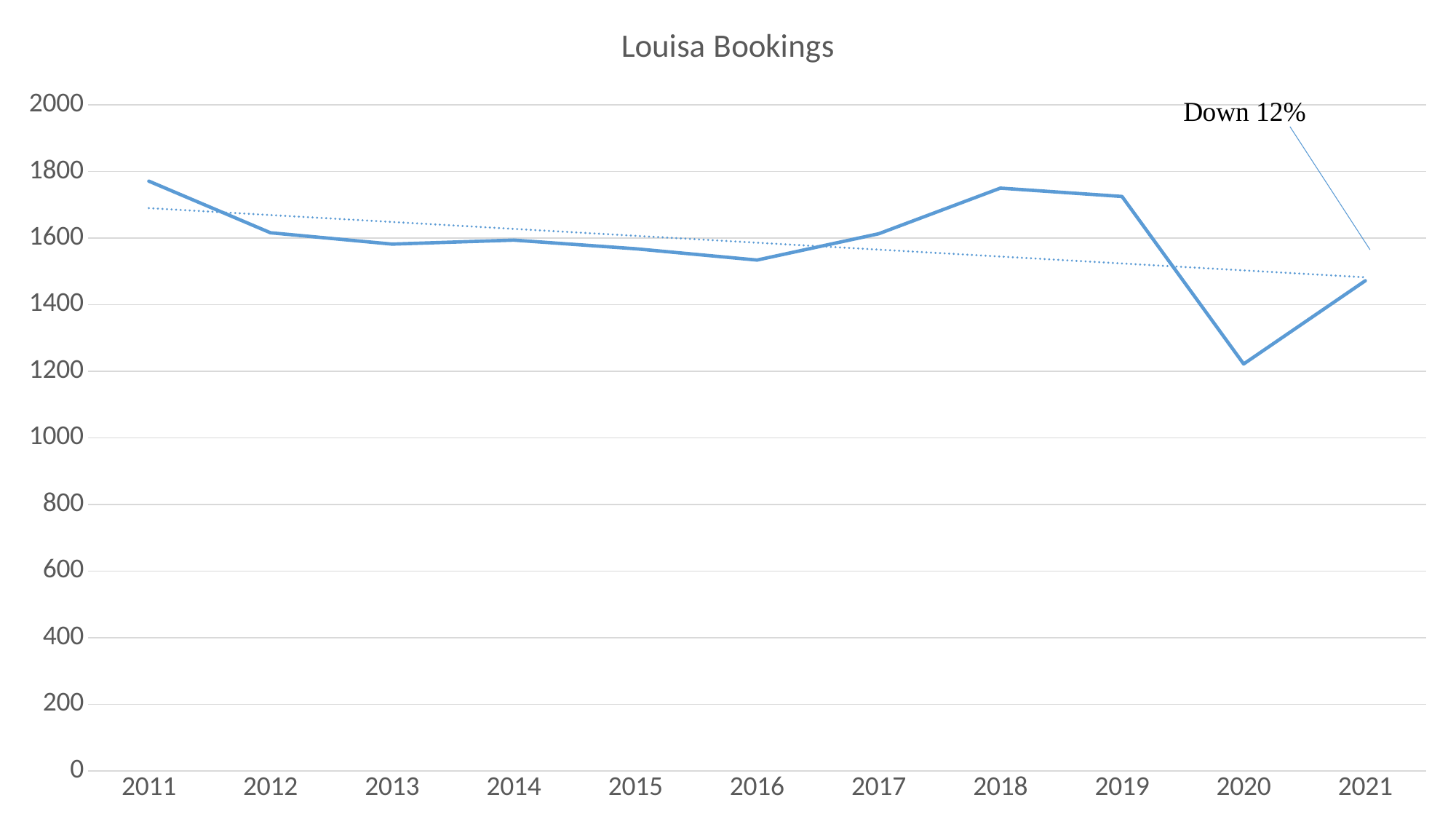
What is the title of the chart? Louisa Bookings Is the value for 2021 greater or less than 1600? less Which year has the larger value, 2018 or 2020? 2018 What kind of chart is shown on the slide? line chart Is the value for 2018 greater or less than 1600? greater Which year has the larger value, 2011 or 2021? 2011 What does the text annotation near the end of the line say? Down 12% Is the value for 2011 greater or less than 1600? greater Which year has the lowest value for Louisa Bookings? 2020 How many years are plotted along the x axis? 11